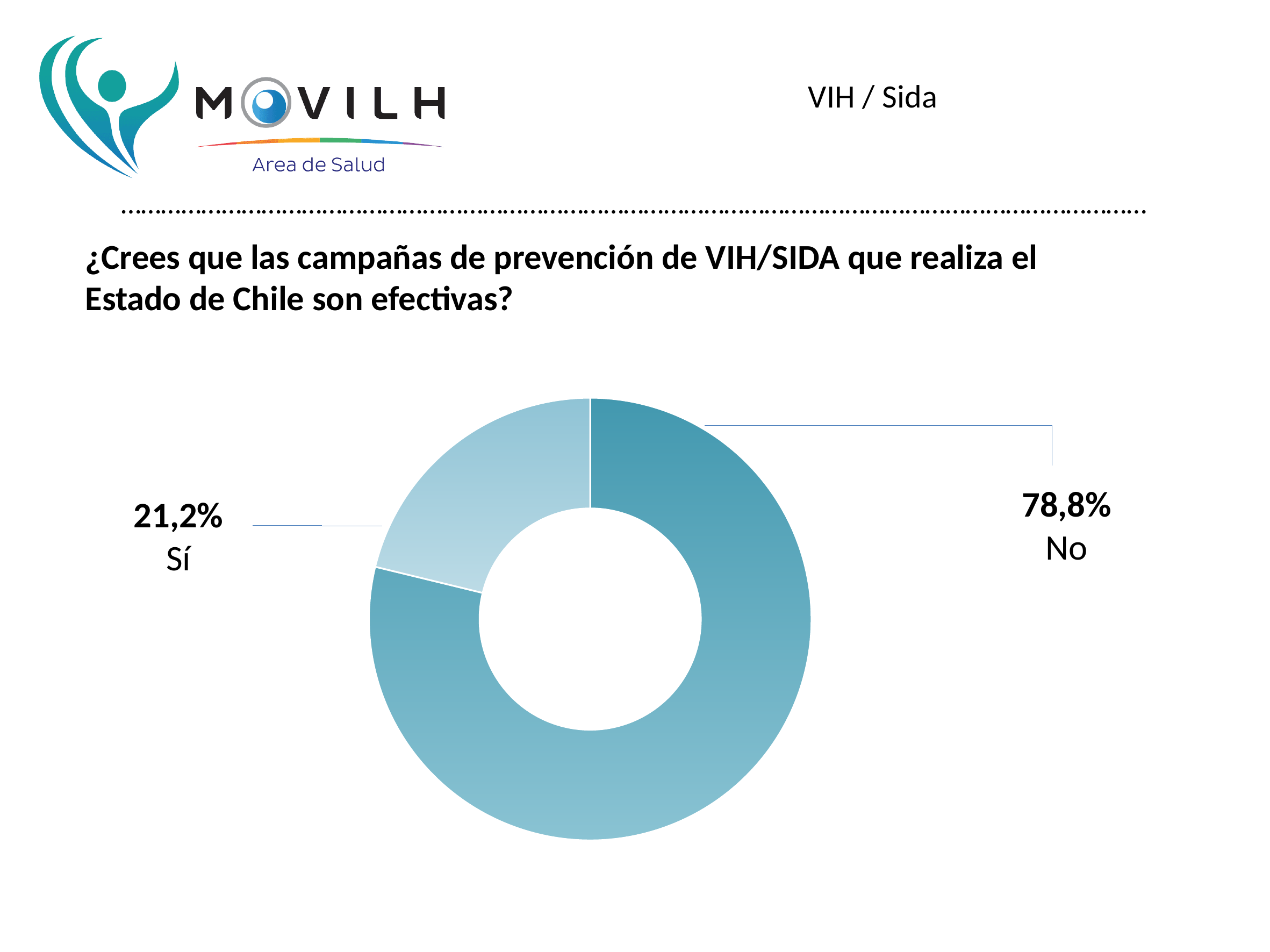
What percentage of respondents answered "No"? 78,8% What percentage of respondents answered "Sí"? 21,2% Is the share for "No" greater or less than 50%? greater Which response is larger, "Sí" or "No"? No What kind of chart is shown on the slide? Doughnut chart What is the total of the two percentages shown in the chart? 100% What question does the chart answer? ¿Crees que las campañas de prevención de VIH/SIDA que realiza el Estado de Chile son efectivas? What is the difference in percentage points between the "No" and "Sí" responses? 57,6 Which response has the largest share of the chart? No Which response has the smallest share of the chart? Sí How many response categories are shown in the chart? 2 Which response is shown in the lighter blue colour? Sí